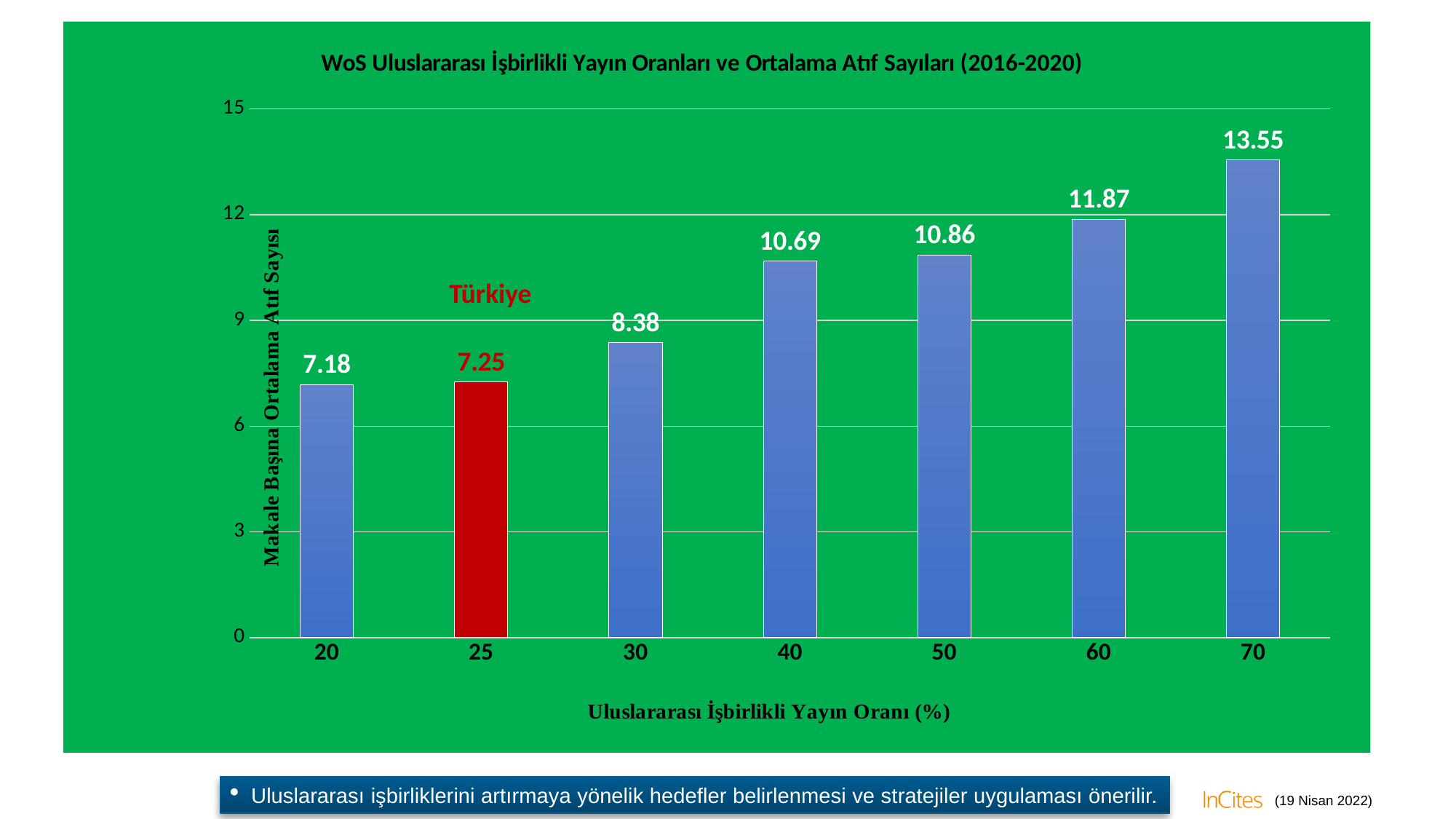
Do the values rise or fall as the international collaboration rate increases along the x axis? rise What is the difference between the values for the 30% category and Türkiye (25%)? 1.13 Which international collaboration rate category has the lowest average citation count? 20 What is the average citation count per article for the 40% international collaboration rate category? 10.69 Is the value for the 60% category greater or less than 12? less What is the difference between the values for the 70% and 60% categories? 1.68 What value is shown for the red bar labelled Türkiye (25%)? 7.25 What kind of chart is shown on the slide? bar chart Which is larger, the value for the 50% category or the 40% category? 50 Which bar is coloured red in the chart? Türkiye (25) Which international collaboration rate category has the highest average citation count? 70 How many bars are shown in the chart? 7